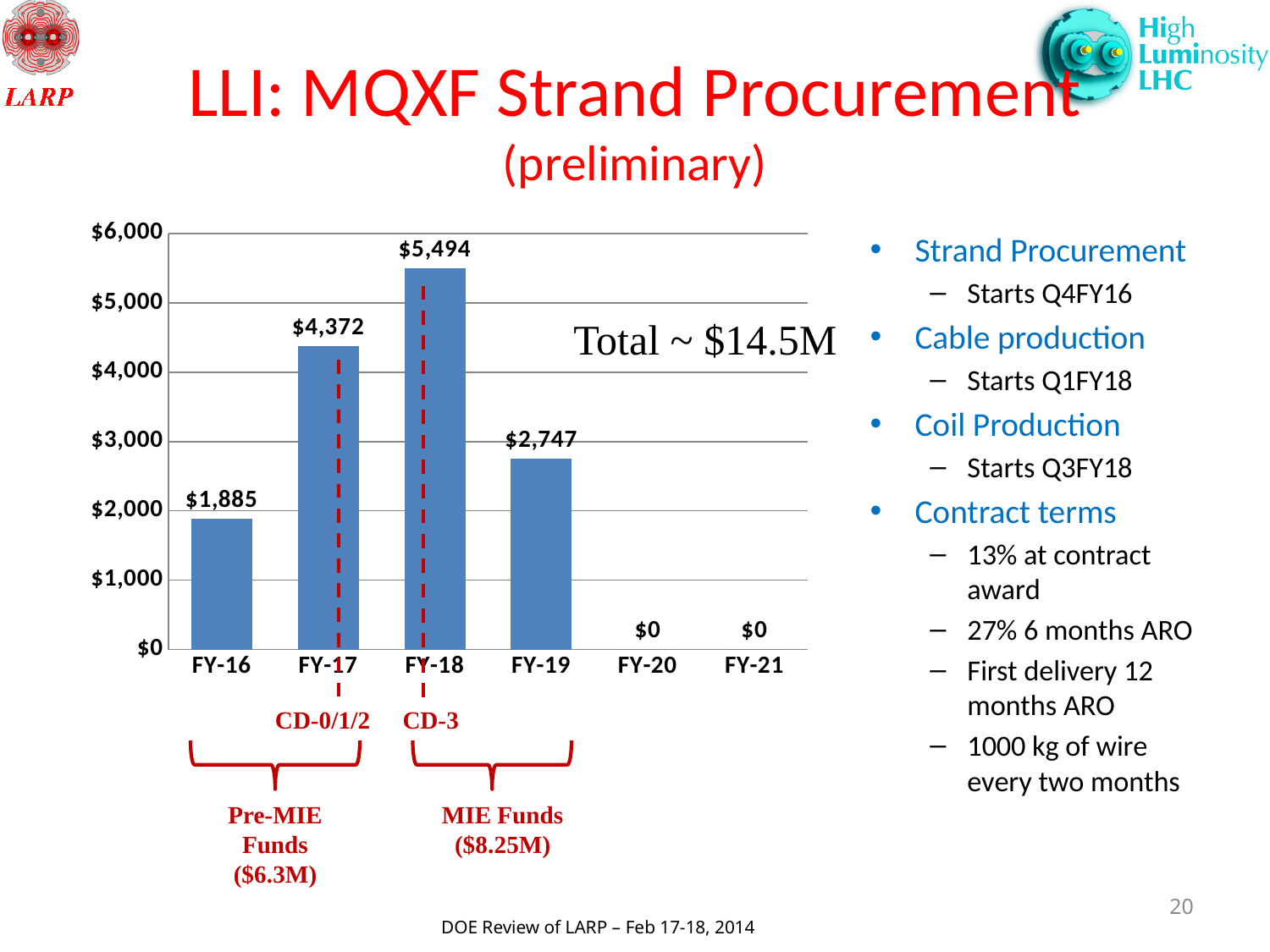
What is the value for FY-18? $5,494 How many fiscal years are shown on the x axis? 6 Is the value for FY-17 greater or less than $4,000? greater What total is annotated on the chart? Total ~ $14.5M Do the values rise or fall from FY-18 to FY-21? fall What is the value shown for FY-20? $0 What is the value for FY-16? $1,885 What kind of chart is shown? bar chart What is the difference between the FY-18 and FY-17 values? $1,122 What is the value for FY-19? $2,747 Which is larger, the value for FY-17 or the value for FY-19? FY-17 Which fiscal year has the highest value? FY-18